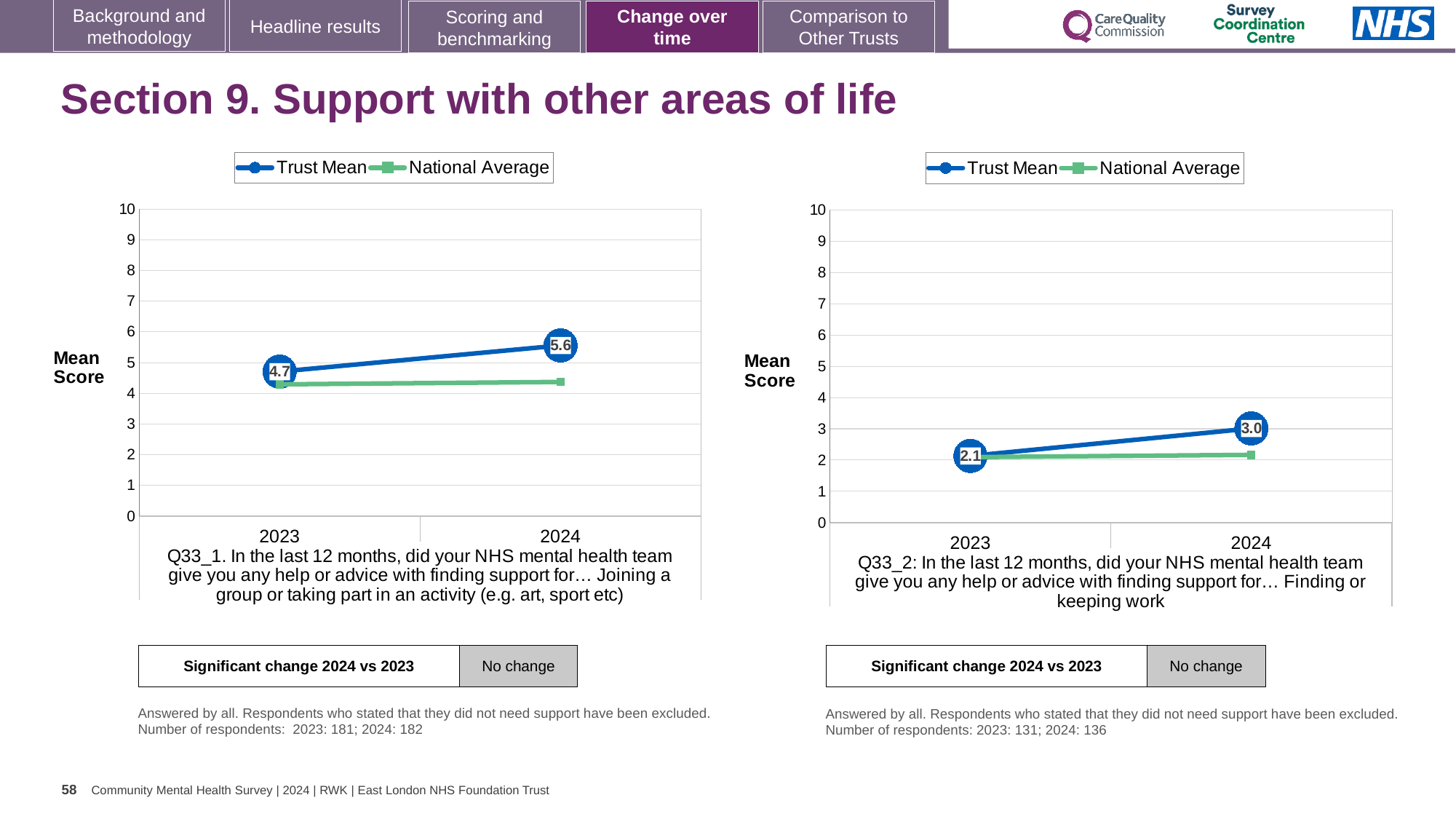
In the left chart (Q33_1), what is the Trust Mean for 2023? 4.7 In the right chart (Q33_2), what is the difference between the Trust Mean in 2024 and in 2023? 0.9 What kind of chart is the right chart (Q33_2)? line chart In the right chart (Q33_2), what is the Trust Mean for 2024? 3.0 In the right chart (Q33_2), what is the Trust Mean for 2023? 2.1 In the right chart (Q33_2), is the National Average for 2024 greater or less than 3? less In the left chart (Q33_1), is the National Average for 2024 greater or less than 5? less In the left chart (Q33_1), what is the Trust Mean for 2024? 5.6 In the right chart (Q33_2), is the Trust Mean in 2024 higher or lower than in 2023? higher In the left chart (Q33_1), does the Trust Mean rise or fall from 2023 to 2024? rise How many series does the legend of the left chart (Q33_1) list? 2 In the left chart (Q33_1), by how much did the Trust Mean change from 2023 to 2024? 0.9